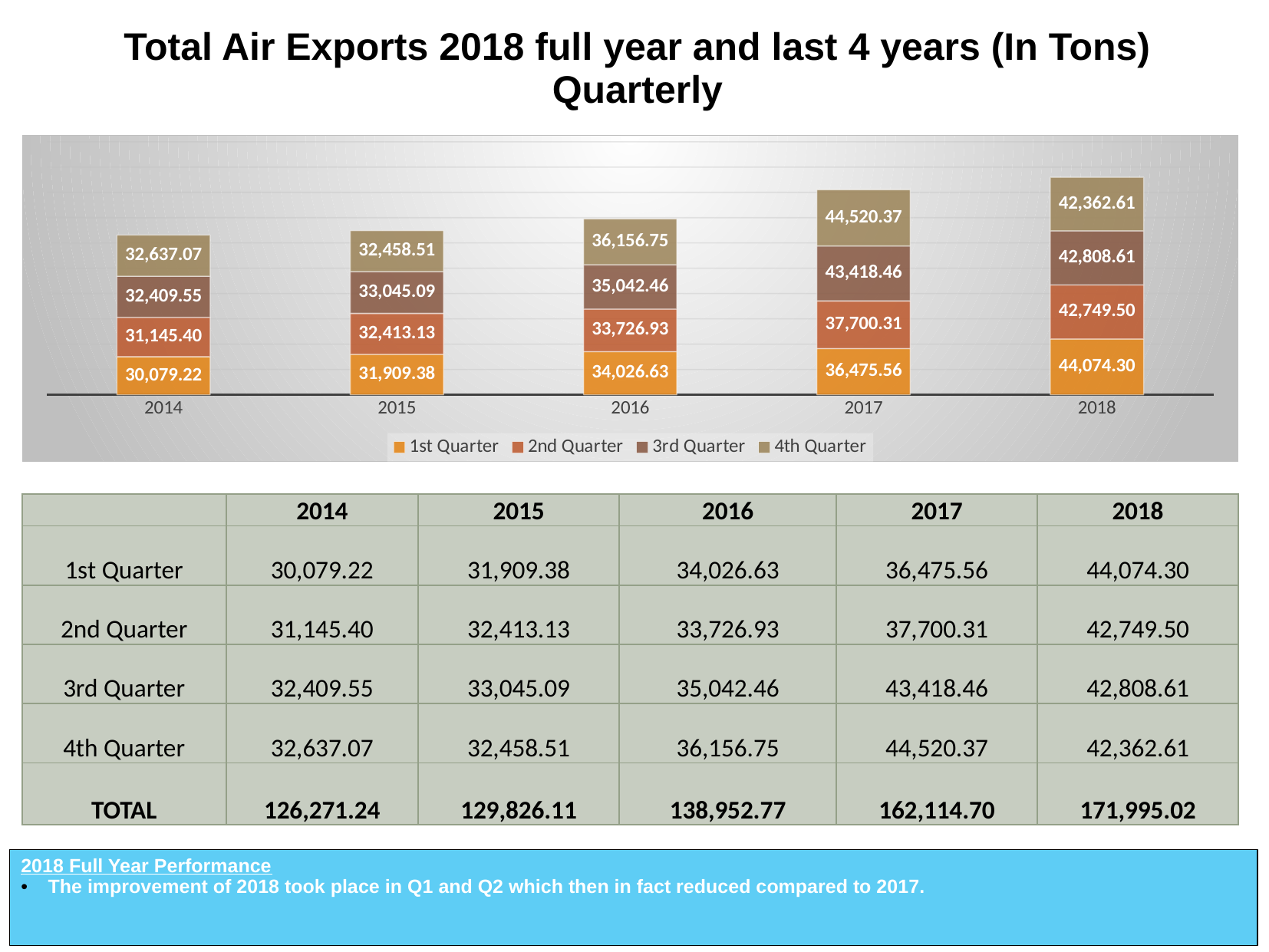
Which year has the highest 1st Quarter value? 2018 What is the 2nd Quarter value for 2016 in the chart? 33,726.93 What is the 1st Quarter value for 2018 in the chart? 44,074.30 Do the total stacked bar heights rise or fall from 2014 to 2018? Rise Which year has the lowest 4th Quarter value? 2015 How many series does the chart legend list? 4 Which is larger: the 3rd Quarter value for 2017 or the 3rd Quarter value for 2018? 2017 How many years are shown on the x axis of the chart? 5 What kind of chart is shown on the slide? Stacked bar chart What is the 4th Quarter value for 2017 in the chart? 44,520.37 What is the total of the stacked bar for 2014? 126,271.24 What is the difference between the 1st Quarter values for 2018 and 2017? 7,598.74